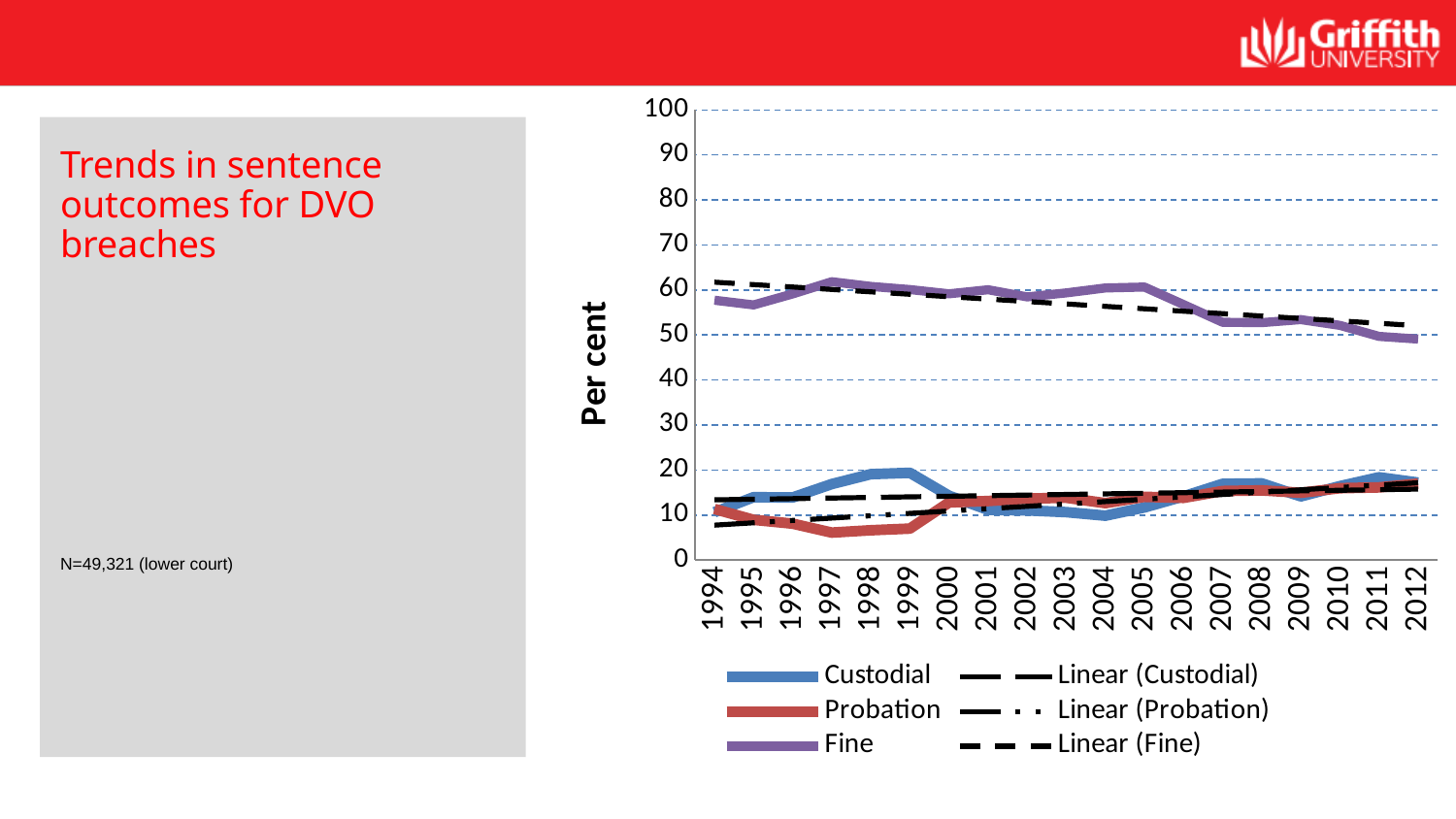
Which is larger in 1998, the value for Custodial or the value for Probation? Custodial How many years are plotted along the x axis of the chart? 19 Is the value for Fine in 1994 greater or less than 50? greater What kind of chart is shown on the slide? line chart Does the Fine series generally rise or fall from 1994 to 2012? fall Is the value for Probation in 1997 greater or less than 10? less What is the label on the vertical axis of the chart? Per cent Is the value for Fine in 2012 greater or less than 60? less How many entries does the chart legend list? 6 Which sentence outcome series has the highest values across all years in the chart? Fine Which series has the lowest value in 1997? Probation